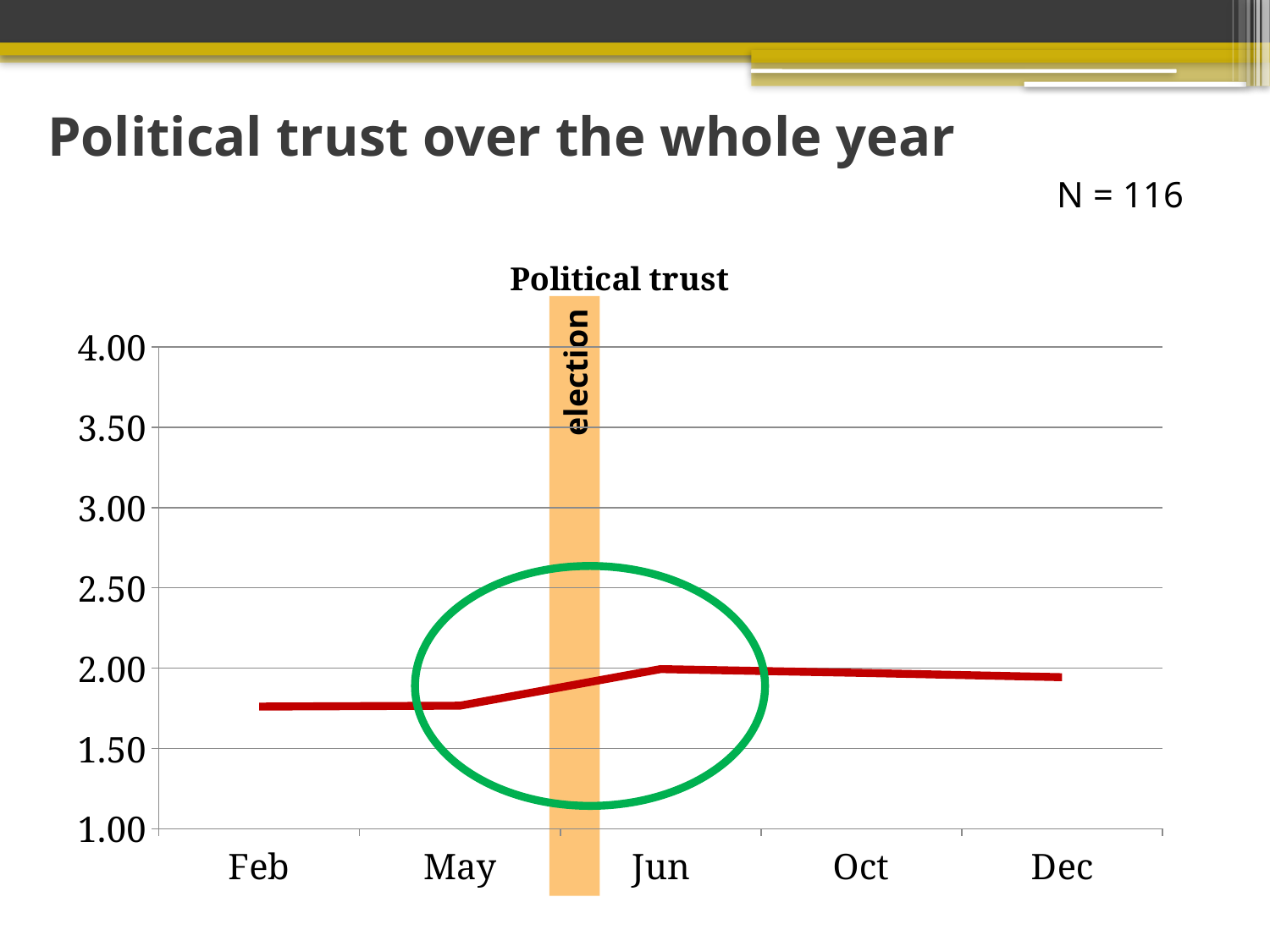
Is the value for May greater or less than 2.00? less Is the value for Jun greater or less than 2.50? less What kind of chart is shown on the slide? line chart How many months are plotted along the x axis of the Political trust chart? 5 Which is larger, the value for Dec or the value for May? Dec What is the title of the chart? Political trust What label is written on the shaded vertical band between May and Jun? election Is the value for Feb greater or less than 1.50? greater Does political trust rise or fall between May and Jun? rise Which is larger, the value for Jun or the value for Feb? Jun